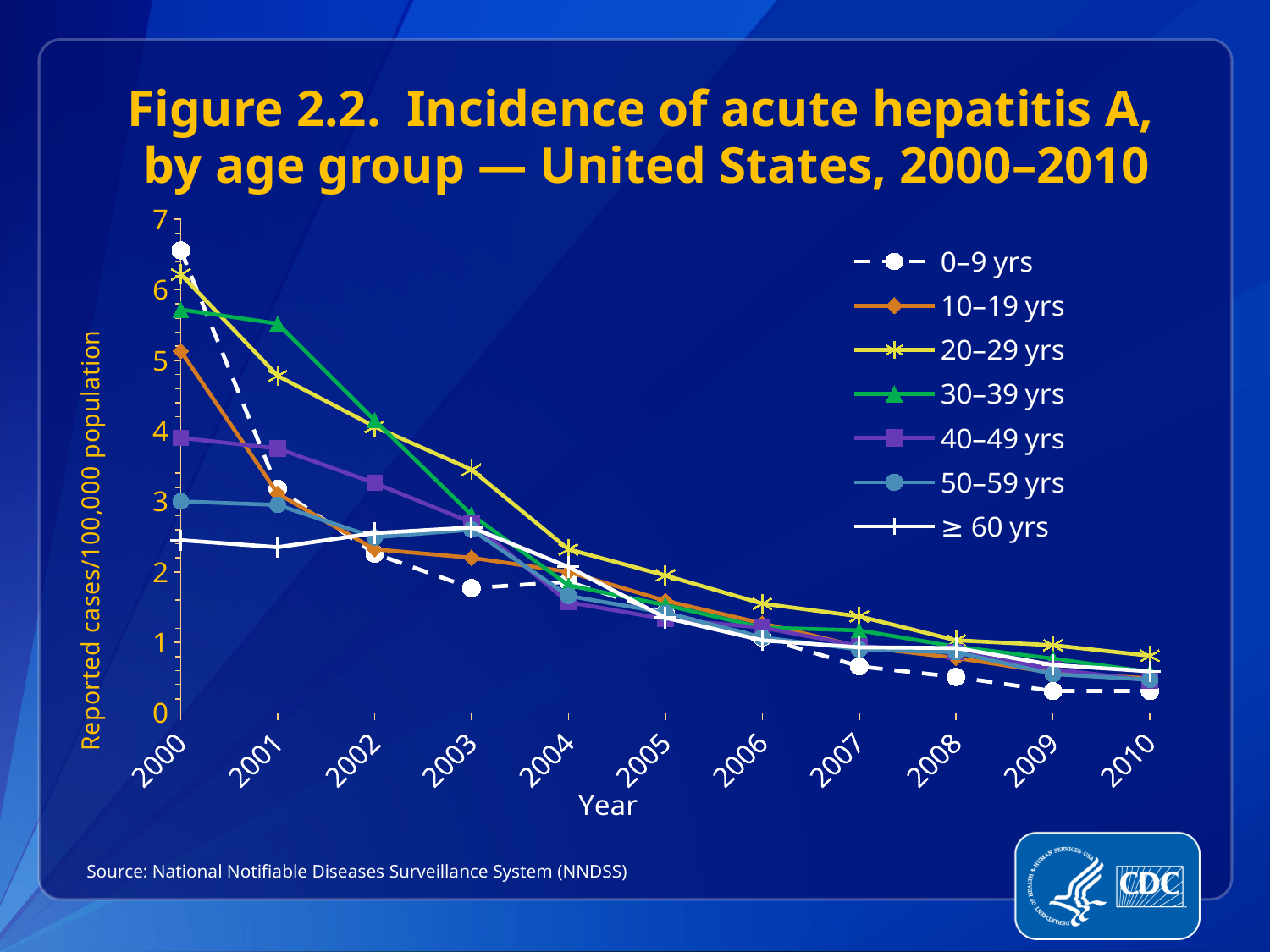
Is the value for the 0–9 yrs group in 2000 greater or less than 6? greater In 2001, which had the higher incidence: the 30–39 yrs group or the 40–49 yrs group? 30–39 yrs What is the label of the y axis? Reported cases/100,000 population What kind of chart is shown on the slide? line chart Which age group had the highest reported incidence in 2010? 20–29 yrs Is the value for the 20–29 yrs group in 2010 greater or less than 1? less Which age group had the lowest reported incidence in 2000? ≥ 60 yrs How many years are plotted along the x axis? 11 Does the incidence for the 20–29 yrs group rise or fall from 2000 to 2010? fall How many age-group series does the legend list? 7 Which age group had the highest reported incidence in 2000? 0–9 yrs Is the value for the ≥ 60 yrs group in 2000 greater or less than 3? less